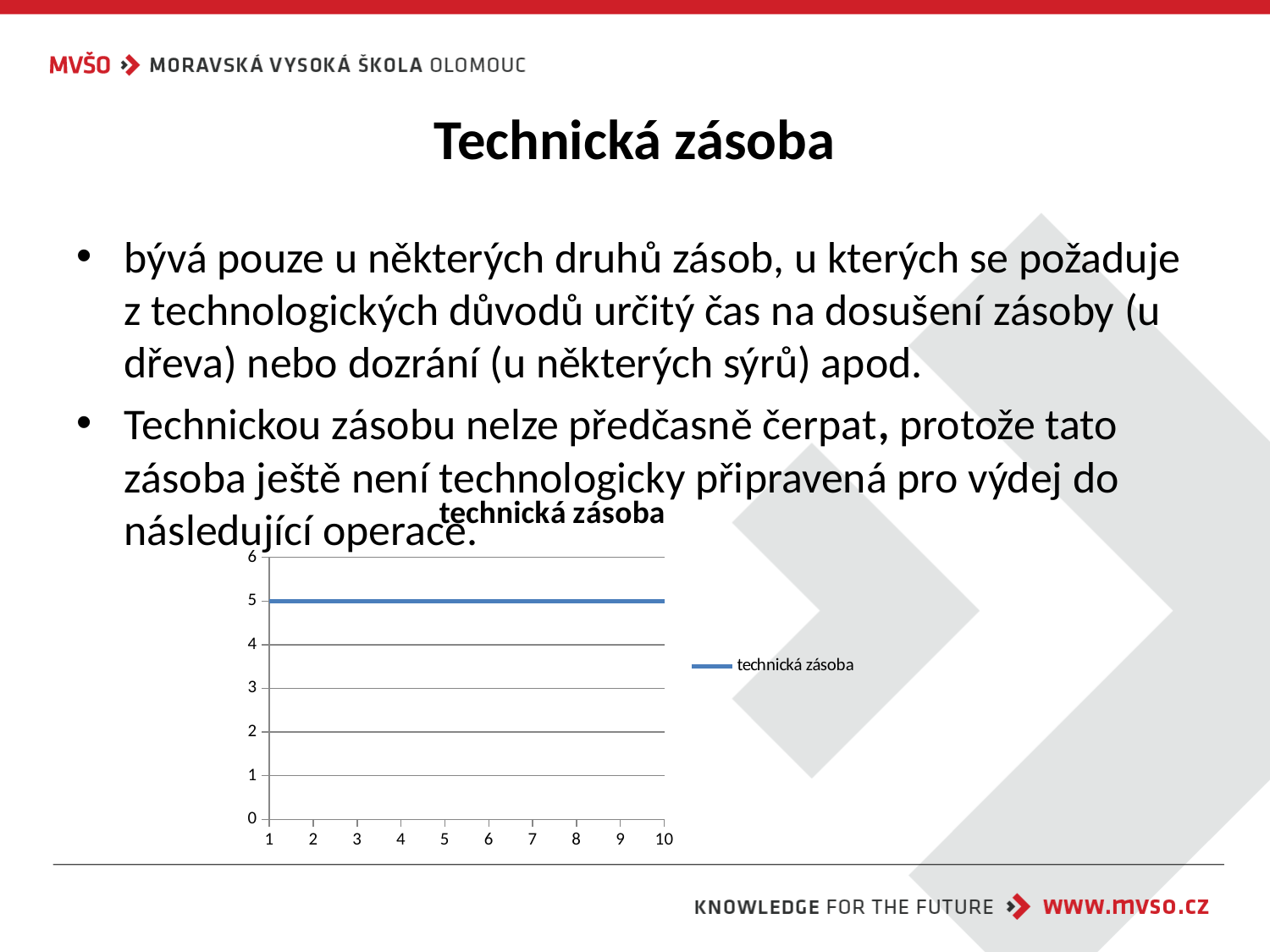
What is the title of the chart? technická zásoba What is the difference between the value at x = 1 and the value at x = 10? 0 How many series does the legend list? 1 How many points are plotted along the x axis? 10 Do the values rise, fall or stay flat along the x axis? stay flat What is the value of technická zásoba at x = 1? 5 What kind of chart is shown on the slide? line chart What is the highest value shown on the y axis? 6 Is the value for technická zásoba at x = 5 greater or less than 4? greater Is the value for technická zásoba at x = 7 greater or less than 6? less What is the name of the series shown in the legend? technická zásoba What is the value of technická zásoba at x = 10? 5